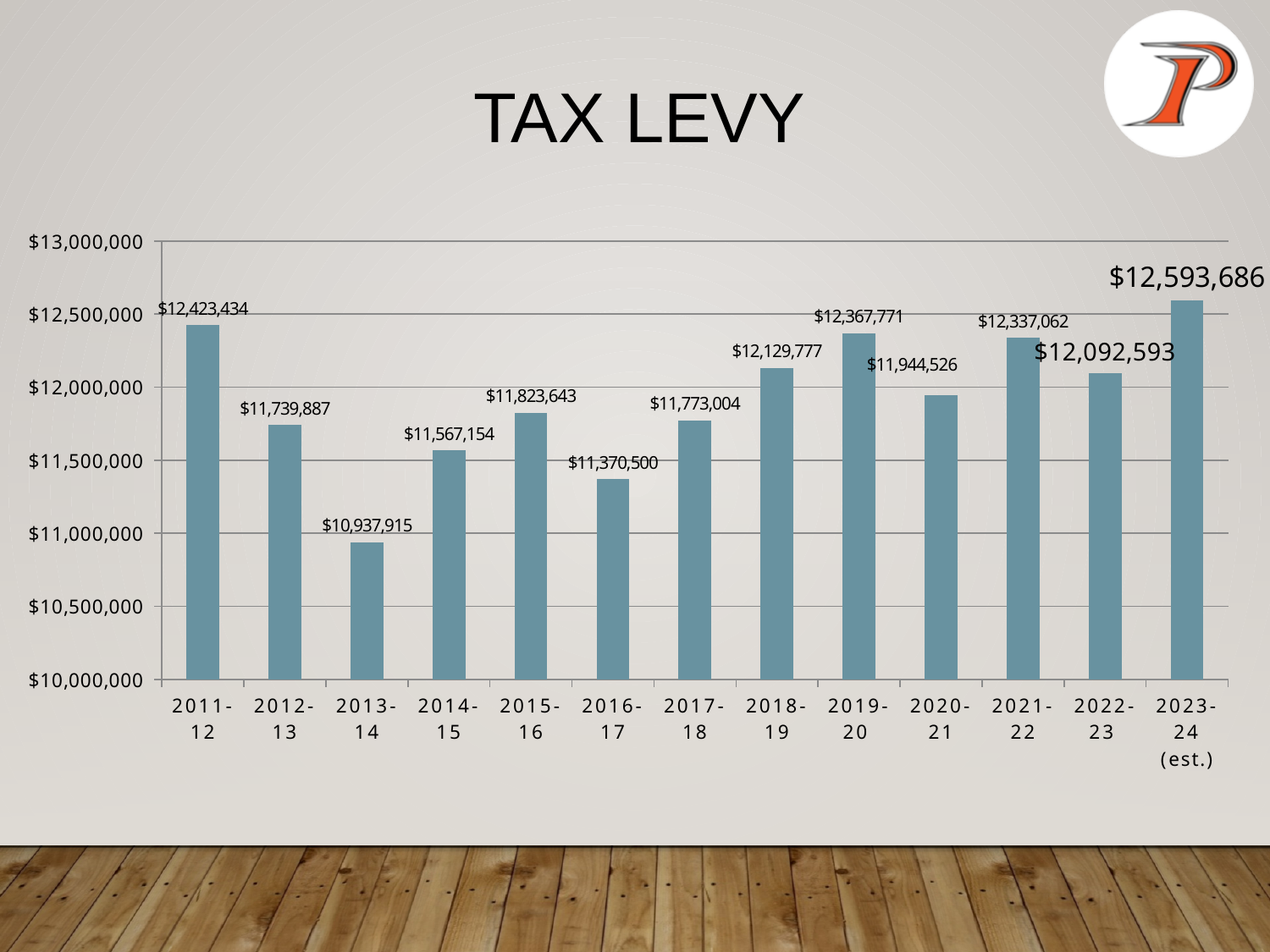
Does the tax levy rise or fall from 2016-17 to 2019-20? rise Which year has the lowest tax levy? 2013-14 What kind of chart is shown on the slide? bar chart How many years are shown on the chart? 13 What is the difference between the tax levy in 2019-20 and in 2018-19? $237,994 What is the estimated tax levy for 2023-24? $12,593,686 Is the tax levy for 2020-21 greater or less than $12,000,000? less Which is larger, the tax levy for 2012-13 or for 2014-15? 2012-13 What is the tax levy for 2013-14? $10,937,915 How much higher is the 2023-24 (est.) tax levy than the 2011-12 tax levy? $170,252 Which year has the highest tax levy? 2023-24 (est.) What is the tax levy for 2019-20? $12,367,771